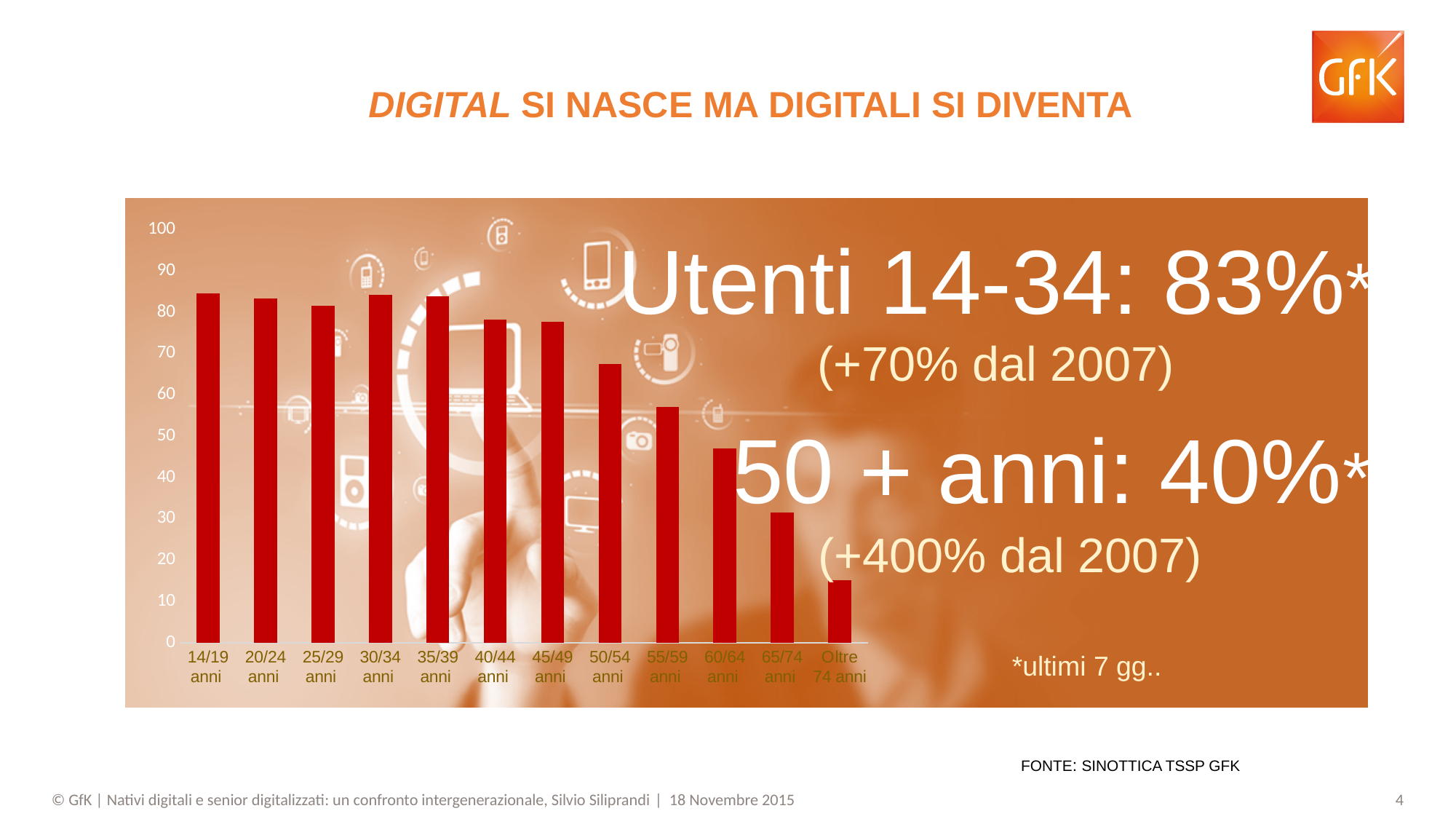
Is the value for 60/64 anni greater or less than 50? less Is the value for 50/54 anni greater or less than 60? greater How many age categories are shown on the x axis of the chart? 12 According to the text overlaid on the chart, what percentage is given for Utenti 14-34? 83% Do the bar values generally rise or fall as age increases along the x axis? fall Which has the larger value, 50/54 anni or 65/74 anni? 50/54 anni What colour are the bars in the chart? red Which age category has the lowest bar in the chart? Oltre 74 anni Is the value for 14/19 anni greater or less than 80? greater What kind of chart is shown on the slide? bar chart